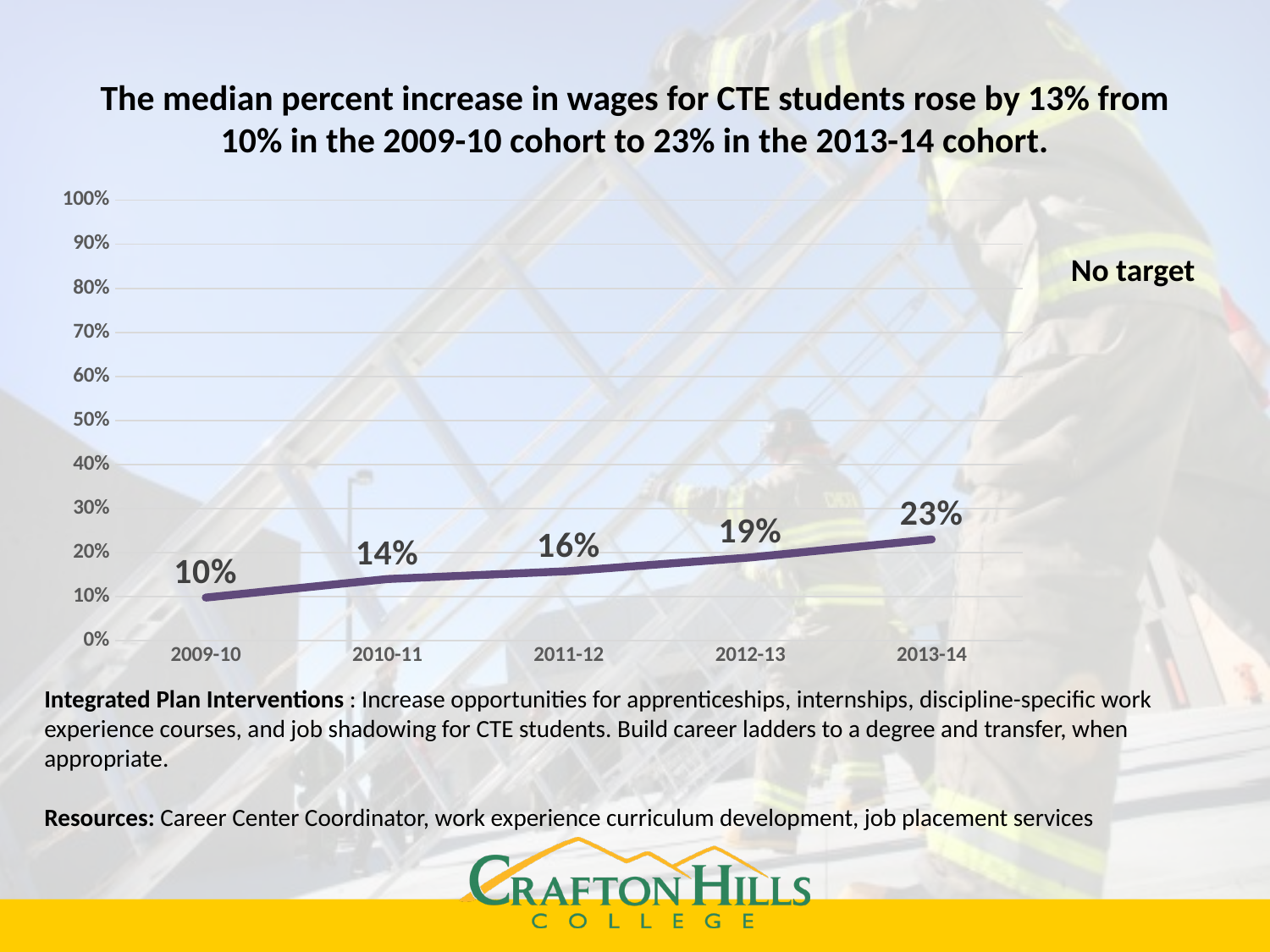
Which cohort has the highest median percent increase in wages? 2013-14 What is the value shown for the 2013-14 cohort? 23% Which cohort has the lowest median percent increase in wages? 2009-10 What is the difference between the 2012-13 value and the 2010-11 value? 5% Is the value for 2013-14 greater or less than 30%? less What is the difference between the 2013-14 value and the 2009-10 value? 13% Which is larger, the value for 2010-11 or the value for 2012-13? 2012-13 What is the value shown for the 2011-12 cohort? 16% How many cohorts are plotted on the chart? 5 What kind of chart is shown on the slide? line chart What is the median percent increase in wages for the 2009-10 cohort? 10% Do the values rise or fall from 2009-10 to 2013-14? rise